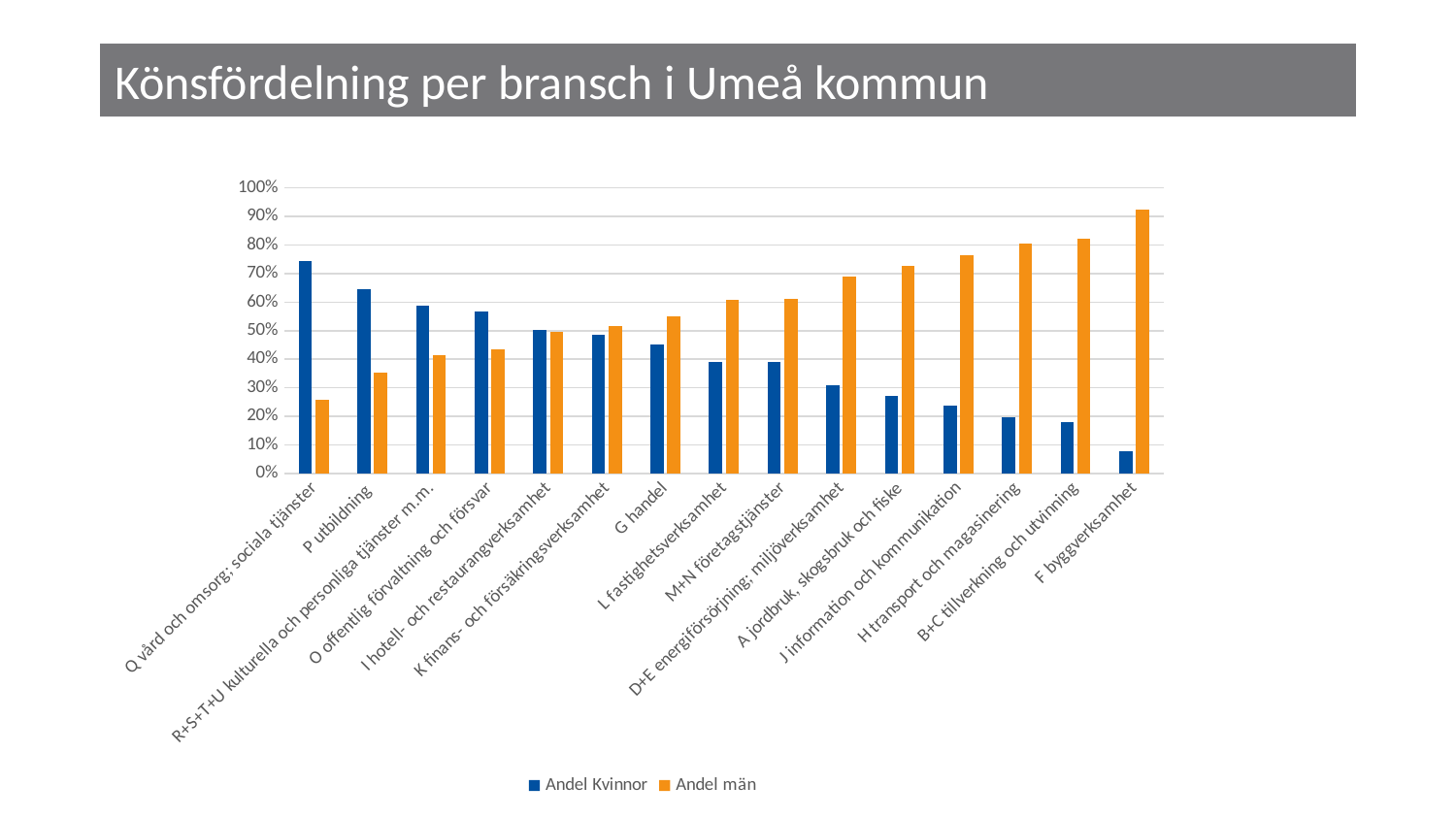
Which category has the lowest value for Andel män? Q vård och omsorg; sociala tjänster For Q vård och omsorg; sociala tjänster, which is larger: Andel Kvinnor or Andel män? Andel Kvinnor How many industry categories are shown on the x axis? 15 How many series does the legend list? 2 Is the Andel Kvinnor value for J information och kommunikation greater or less than 30%? less What kind of chart is shown on the slide? Bar chart Is the Andel Kvinnor value for P utbildning greater or less than 60%? greater Does the Andel Kvinnor series generally rise or fall from left to right along the x axis? Fall What is the title of the chart? Könsfördelning per bransch i Umeå kommun Which category has the lowest value for Andel Kvinnor? F byggverksamhet Which category has the highest value for Andel män? F byggverksamhet Which category has the highest value for Andel Kvinnor? Q vård och omsorg; sociala tjänster